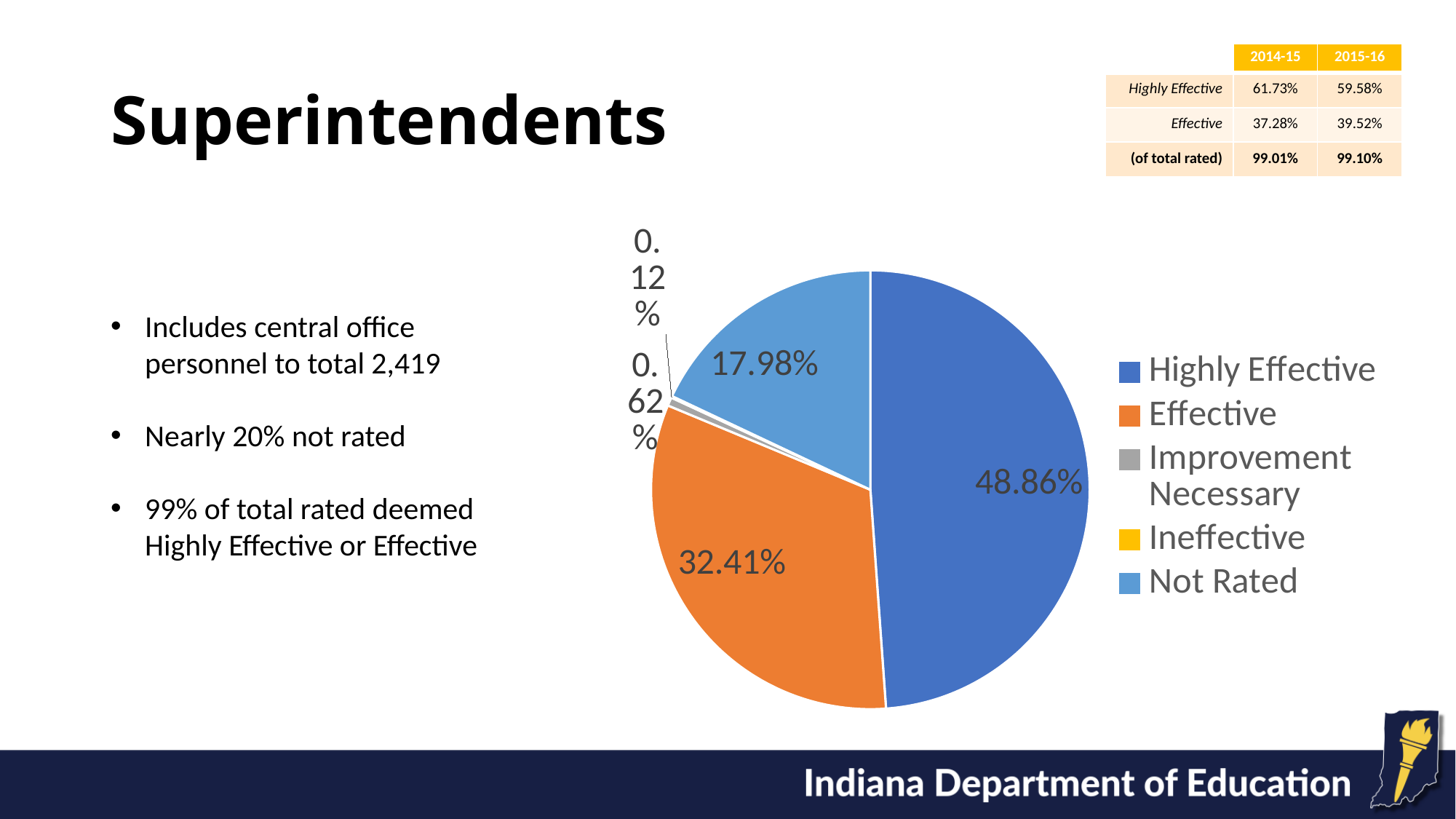
What kind of chart is shown on the slide? pie chart Which category has the largest slice of the pie? Highly Effective What percentage of the pie is Not Rated? 17.98% What colour is the Effective slice in the pie chart? orange What percentage of the pie is Effective? 32.41% Which slice is larger, Effective or Not Rated? Effective How many categories does the legend of the pie chart list? 5 Which category has the smallest slice of the pie? Ineffective What percentage of the pie is Highly Effective? 48.86% What is the difference in percentage points between the Highly Effective and Effective slices? 16.45 What percentage of the pie is Improvement Necessary? 0.62% What colour is the Not Rated slice in the pie chart? light blue